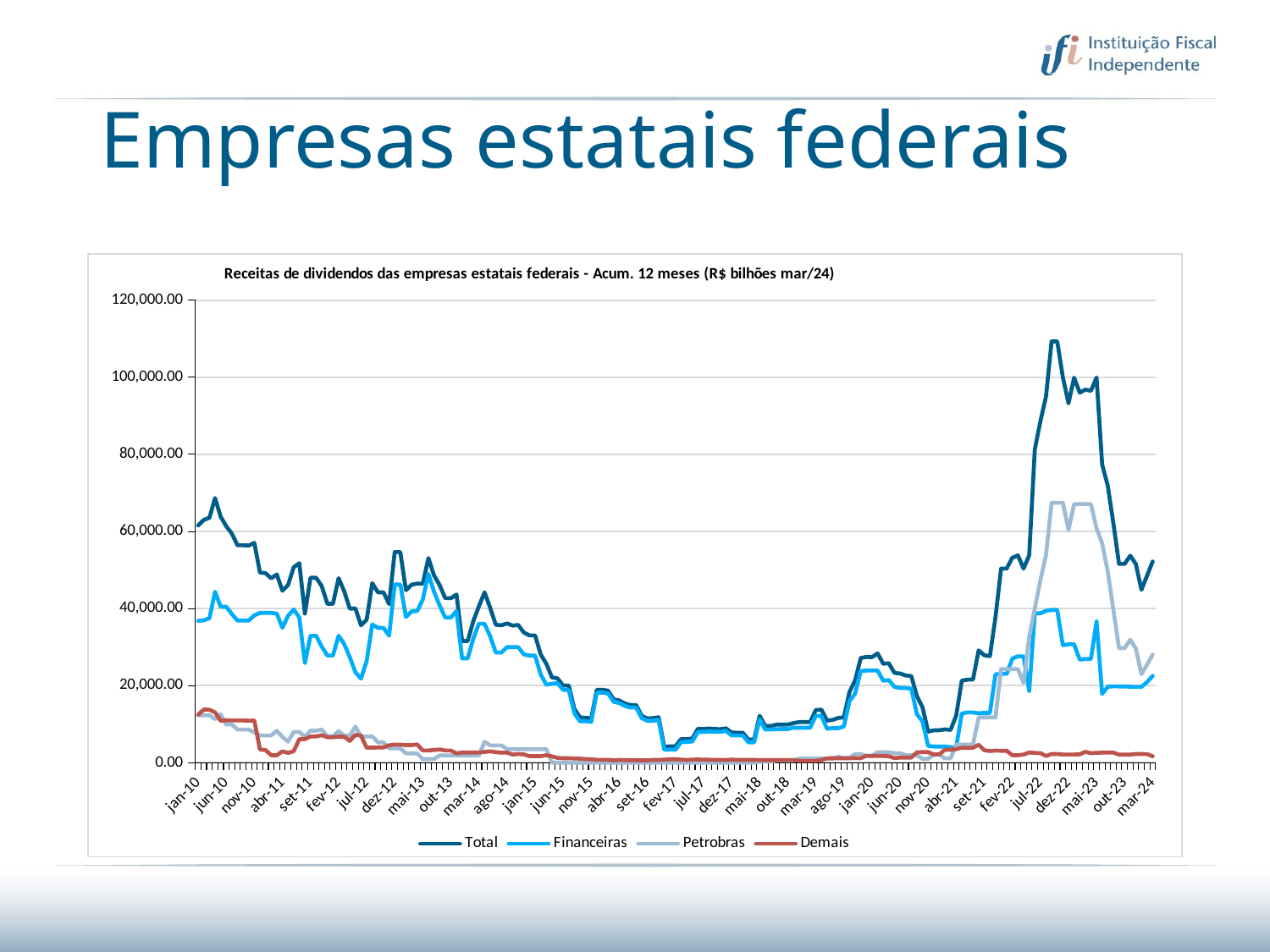
How many series does the legend list? 4 Which series has the lowest value at mar-24? Demais At jan-10, which is larger: Financeiras or Petrobras? Financeiras Around dez-22, which is larger: Petrobras or Financeiras? Petrobras What kind of chart is shown on the slide? Line chart What is the title of the chart? Receitas de dividendos das empresas estatais federais - Acum. 12 meses (R$ bilhões mar/24) Does the Total series rise or fall between jan-10 and jan-15? Fall Is the value of the Petrobras series at its peak around dez-22 greater or less than 80,000.00? less Is the value of the Total series at its peak around dez-22 greater or less than 100,000.00? greater Which series are listed in the legend? Total, Financeiras, Petrobras, Demais Is the value of the Financeiras series at jan-10 greater or less than 40,000.00? less